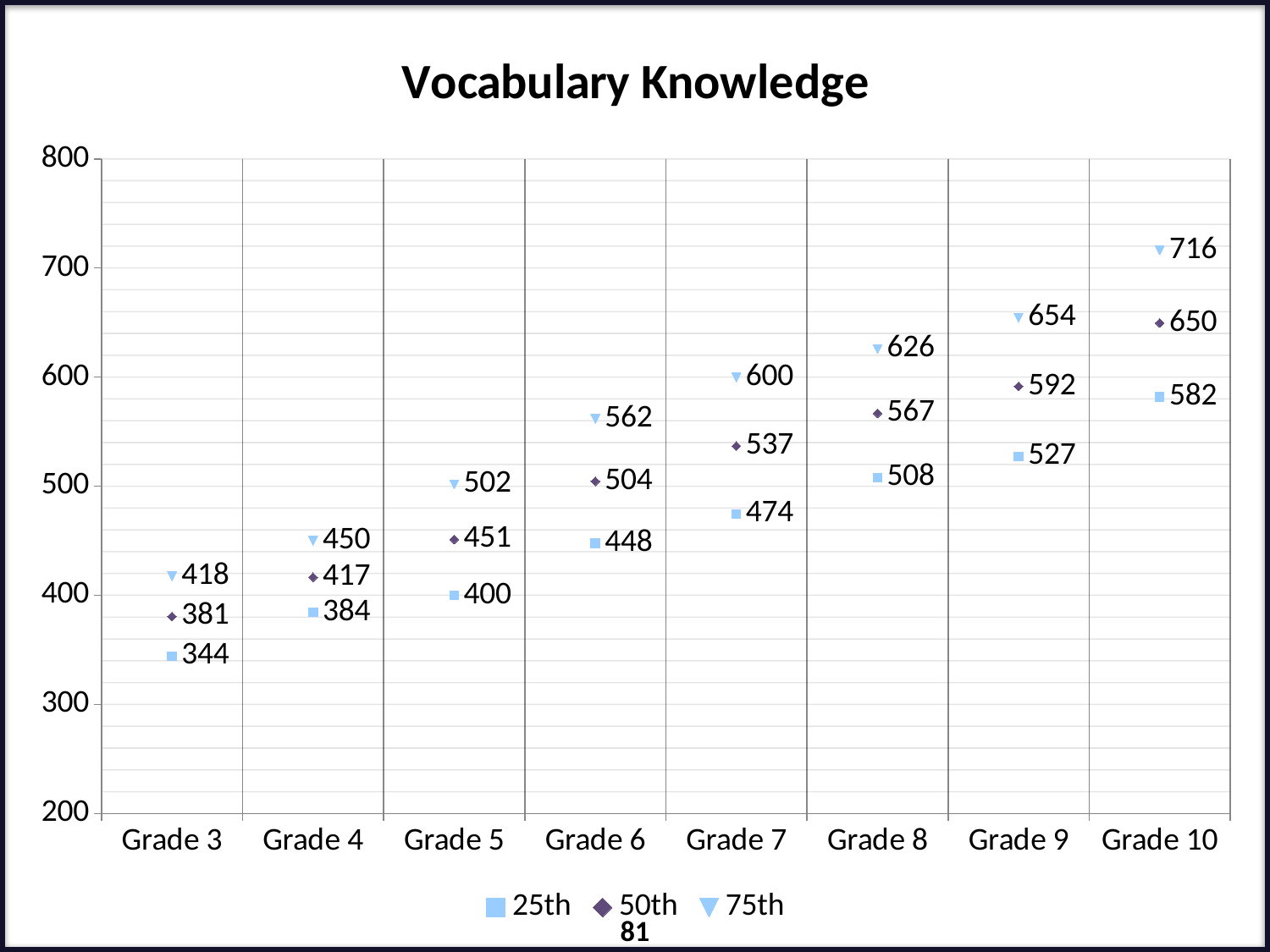
What is the 25th percentile value for Grade 3? 344 Which is larger: the 50th percentile value for Grade 8 or the 75th percentile value for Grade 5? 50th percentile for Grade 8 Is the 25th percentile value for Grade 9 greater or less than 500? greater What is the 75th percentile value for Grade 10? 716 How many grades are shown on the x axis? 8 Which grade has the lowest 25th percentile value? Grade 3 How many series does the legend list? 3 Which grade has the highest 75th percentile value? Grade 10 What is the difference between the 75th and 25th percentile values for Grade 6? 114 Do the 50th percentile values rise or fall from Grade 3 to Grade 10? rise What is the title of the chart? Vocabulary Knowledge What is the 50th percentile value for Grade 7? 537